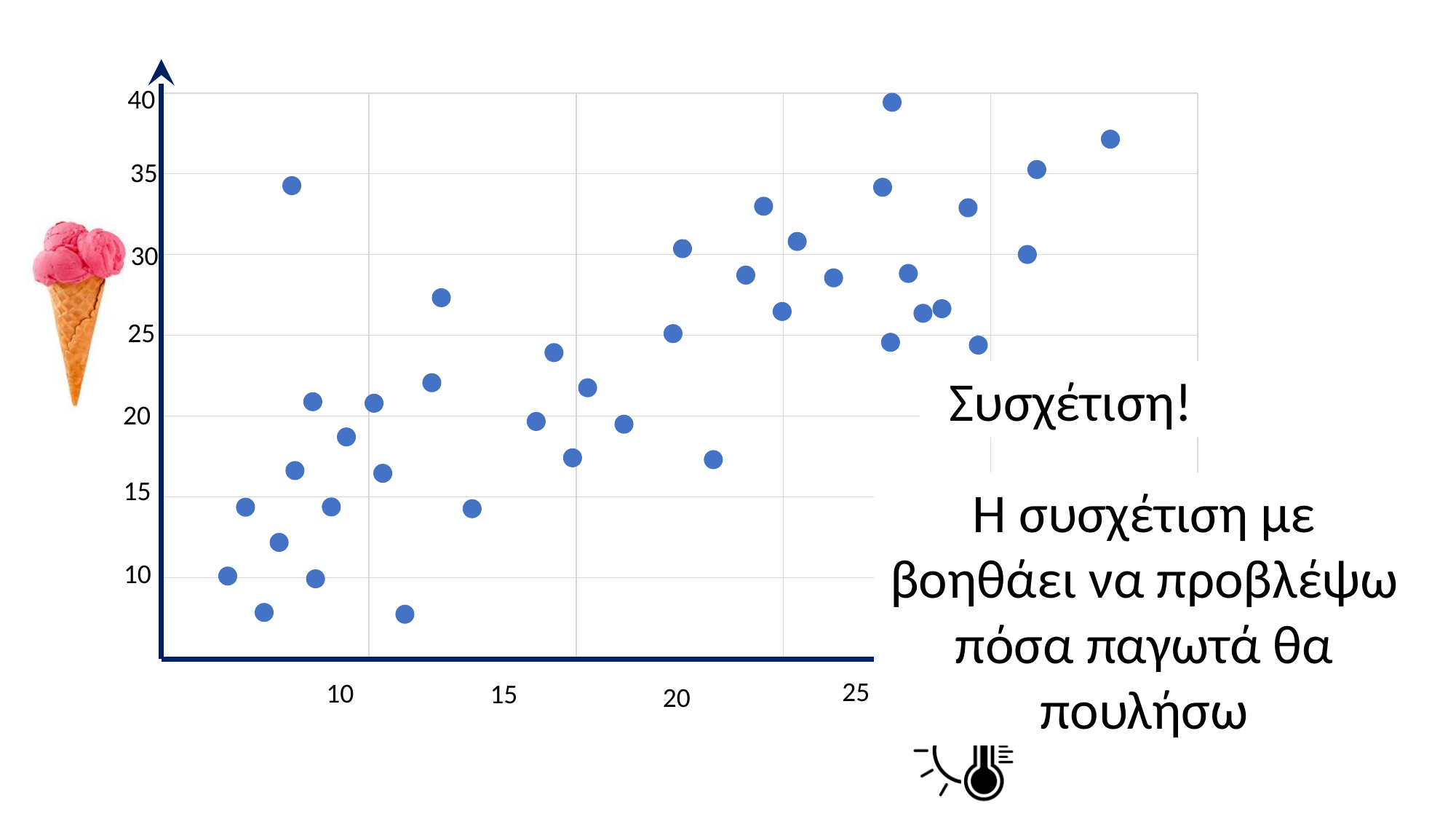
Is the highest plotted point on the chart greater or less than 35 on the y axis? greater Is the point plotted furthest to the right on the chart greater or less than 35 on the y axis? greater What is the lowest value labelled on the x axis of the chart? 10 What is the highest value labelled on the y axis of the chart? 40 Is the lowest plotted point on the chart greater or less than 10 on the y axis? less Do the plotted values generally rise or fall as you move along the x axis from left to right? rise What kind of chart is shown on the slide? scatter chart